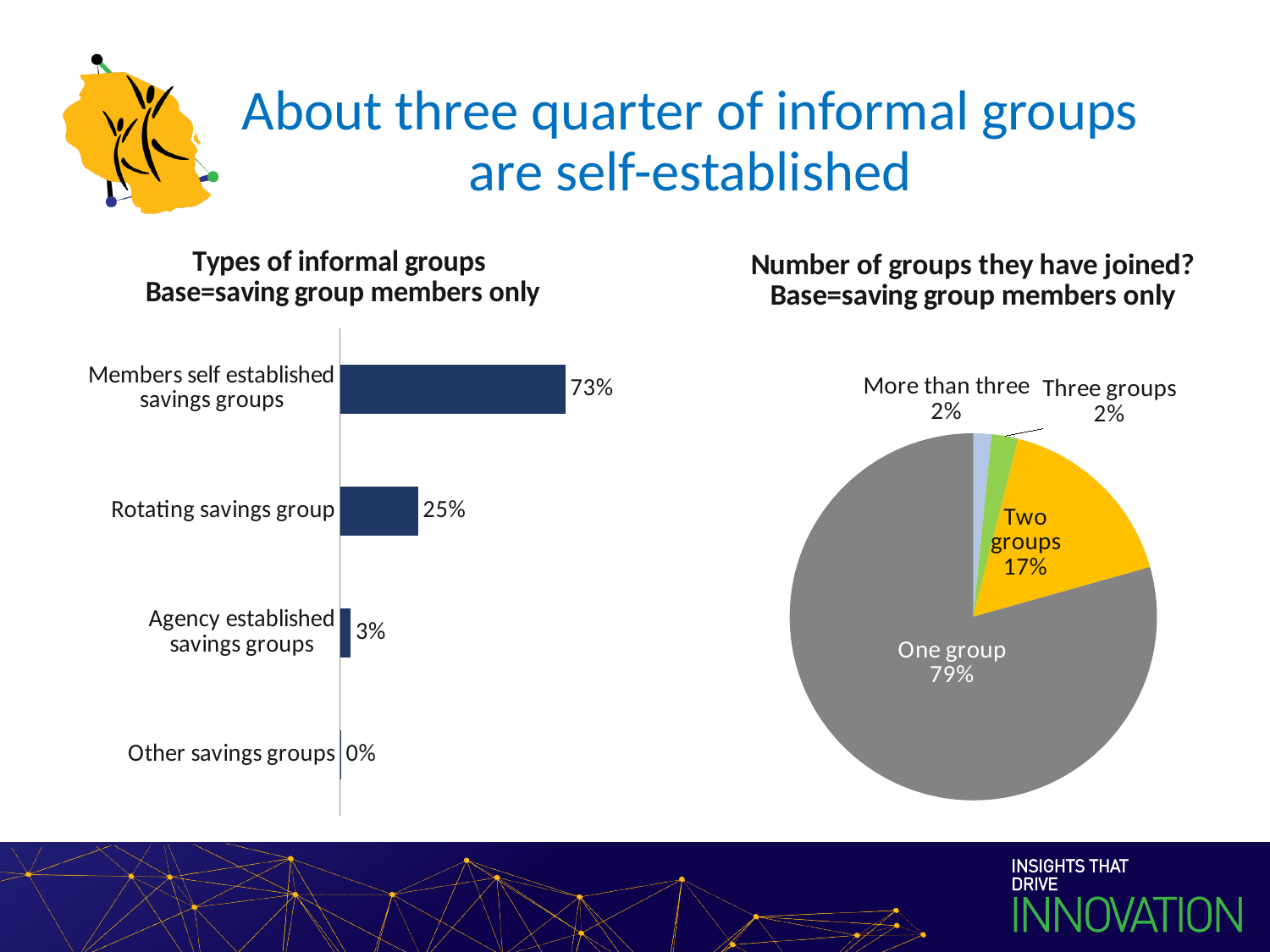
What kind of chart is the 'Types of informal groups' chart? Bar chart In the 'Types of informal groups' chart, which category has the highest value? Members self established savings groups In the 'Types of informal groups' chart, what is the difference between Members self established savings groups and Rotating savings group? 48% What kind of chart is the 'Number of groups they have joined?' chart? Pie chart In the 'Types of informal groups' chart, what is the value for Members self established savings groups? 73% In the 'Number of groups they have joined?' chart, which slice is the largest? One group In the 'Number of groups they have joined?' chart, how many slices are there? 4 In the 'Types of informal groups' chart, which category has the lowest value? Other savings groups In the 'Types of informal groups' chart, what is the value for Rotating savings group? 25% In the 'Number of groups they have joined?' chart, what share is One group? 79% In the 'Types of informal groups' chart, how many categories are shown? 4 In the 'Number of groups they have joined?' chart, what share is Two groups? 17%